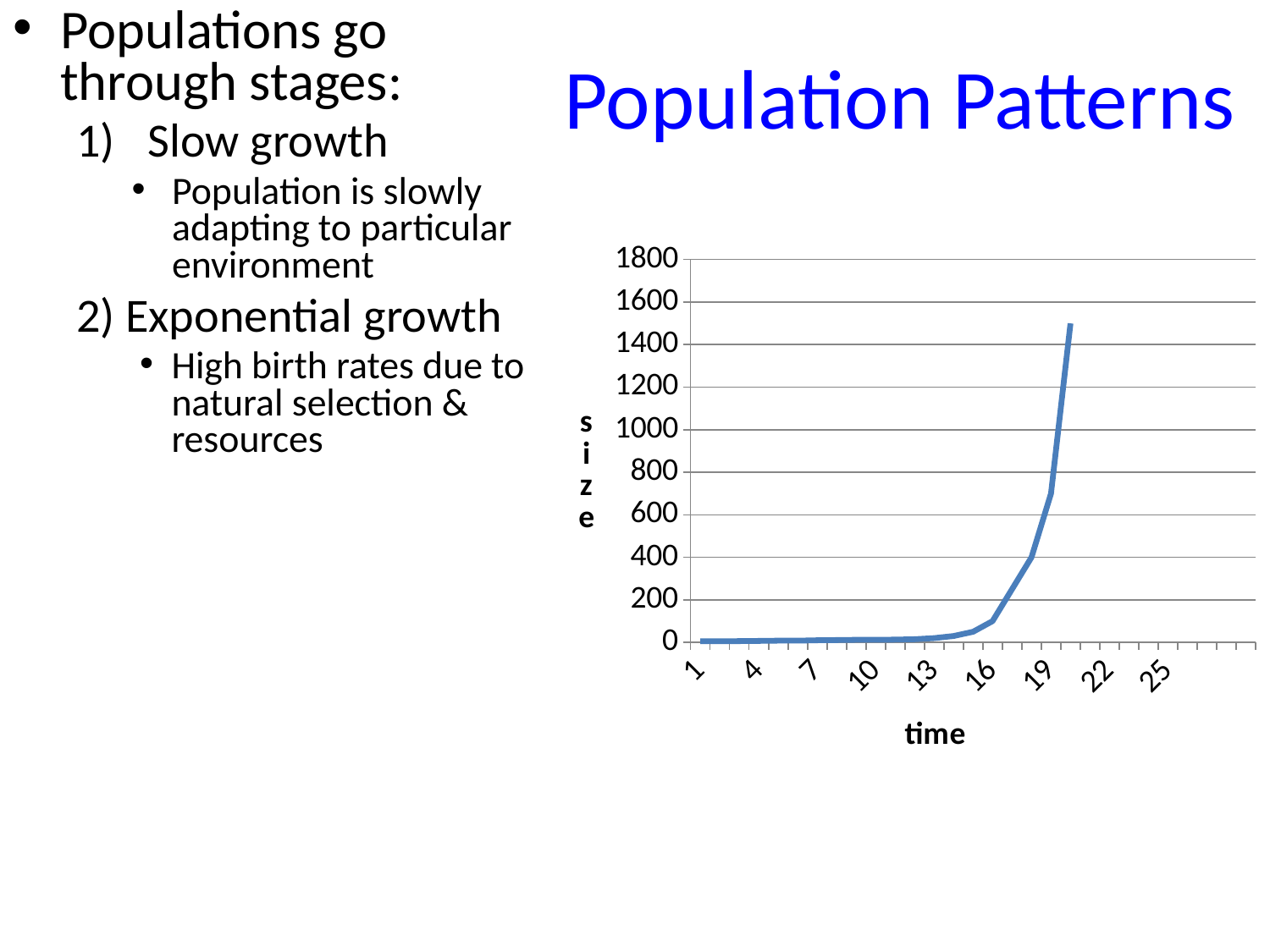
Is the highest value reached by the line greater or less than 1000? greater Do the values on the chart rise or fall as time increases along the x axis? rise What kind of chart is shown on the slide? line chart How many tick labels are printed along the horizontal axis? 9 What is the label on the vertical axis of the chart? size How many lines (series) are plotted on the chart? 1 Is the value at time 4 greater or less than 400? less Is the value at time 10 greater or less than 200? less What is the label on the horizontal axis of the chart? time Which is larger, the value at time 7 or the value at time 19? time 19 What is the highest tick value shown on the vertical axis? 1800